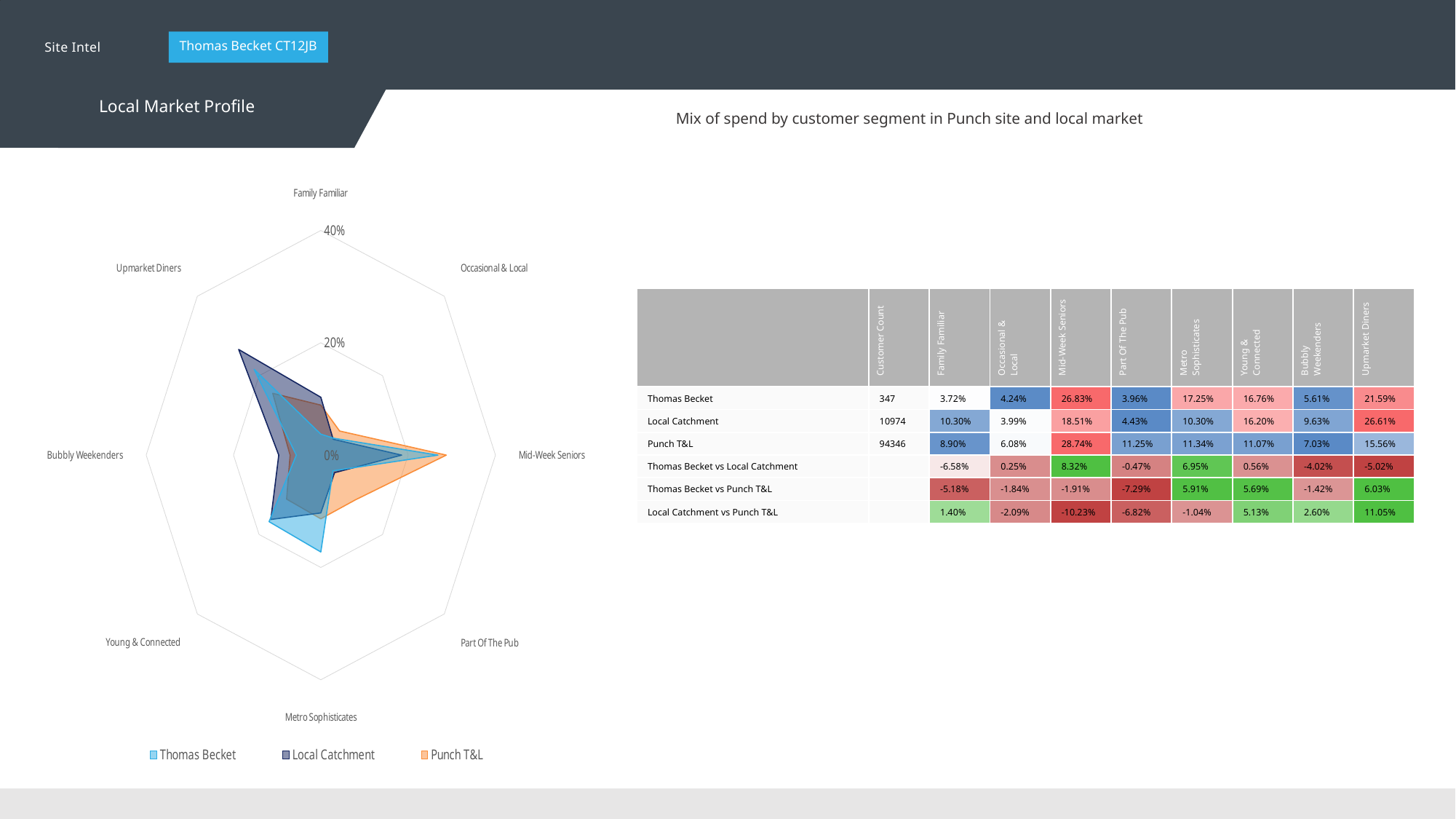
How many customer segments (axes) does the radar chart have? 8 Which three series are listed in the radar chart's legend? Thomas Becket, Local Catchment, Punch T&L What is the Thomas Becket value for Mid-Week Seniors? 26.83% Which is larger for Part Of The Pub: Thomas Becket or Punch T&L? Punch T&L What kind of chart is shown on the left of the slide? Radar chart How many series does the radar chart's legend list? 3 What is the difference between Thomas Becket and Local Catchment for Mid-Week Seniors? 8.32% Which customer segment has the highest value for Thomas Becket? Mid-Week Seniors What is the Local Catchment value for Upmarket Diners? 26.61% Which customer segment has the lowest value for Thomas Becket? Family Familiar Is the Punch T&L value for Mid-Week Seniors greater or less than 20%? greater What is the Punch T&L value for Part Of The Pub? 11.25%